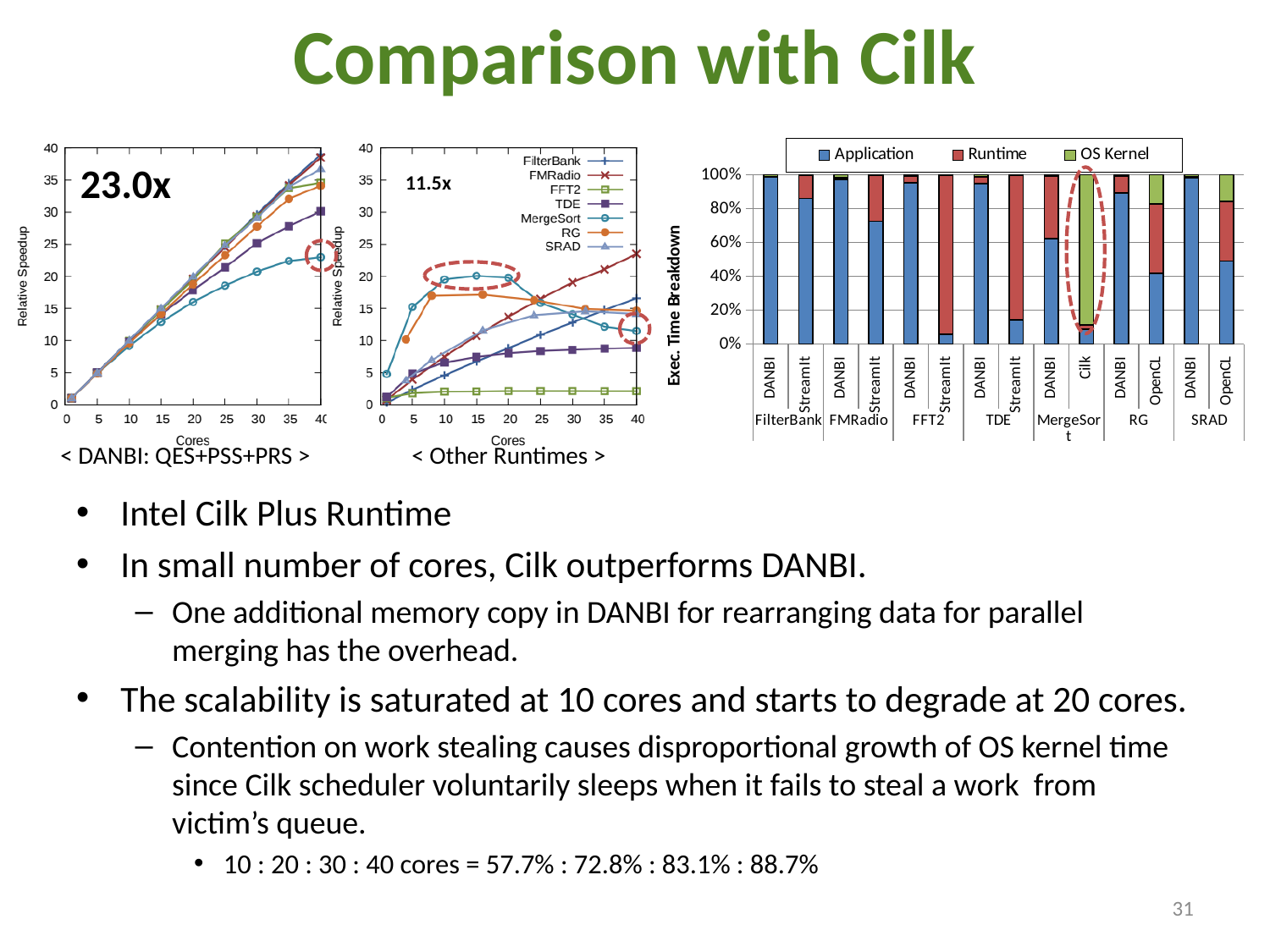
What peak speedup value is annotated on the '< Other Runtimes >' chart? 11.5x How many series does the legend of the 'Exec. Time Breakdown' chart list? 3 How many bars are plotted in the 'Exec. Time Breakdown' chart? 14 In the 'Exec. Time Breakdown' chart, is the Application share for the Cilk bar under MergeSort greater or less than 20%? less What peak speedup value is annotated on the '< DANBI: QES+PSS+PRS >' chart? 23.0x In the 'Exec. Time Breakdown' chart, which bar has the largest OS Kernel share? Cilk (MergeSort) What kind of chart is the 'Exec. Time Breakdown' chart on the right of the slide? stacked bar chart In the 'Exec. Time Breakdown' chart, for MergeSort, which bar has the larger Application share, DANBI or Cilk? DANBI What kind of chart is the '< DANBI: QES+PSS+PRS >' chart on the left of the slide? line chart How many series does the legend of the '< Other Runtimes >' line chart list? 7 In the 'Exec. Time Breakdown' chart, is the Application share for the DANBI bar under FilterBank greater or less than 80%? greater In the '< DANBI: QES+PSS+PRS >' chart, does the relative speedup generally rise or fall as the number of cores increases? rise